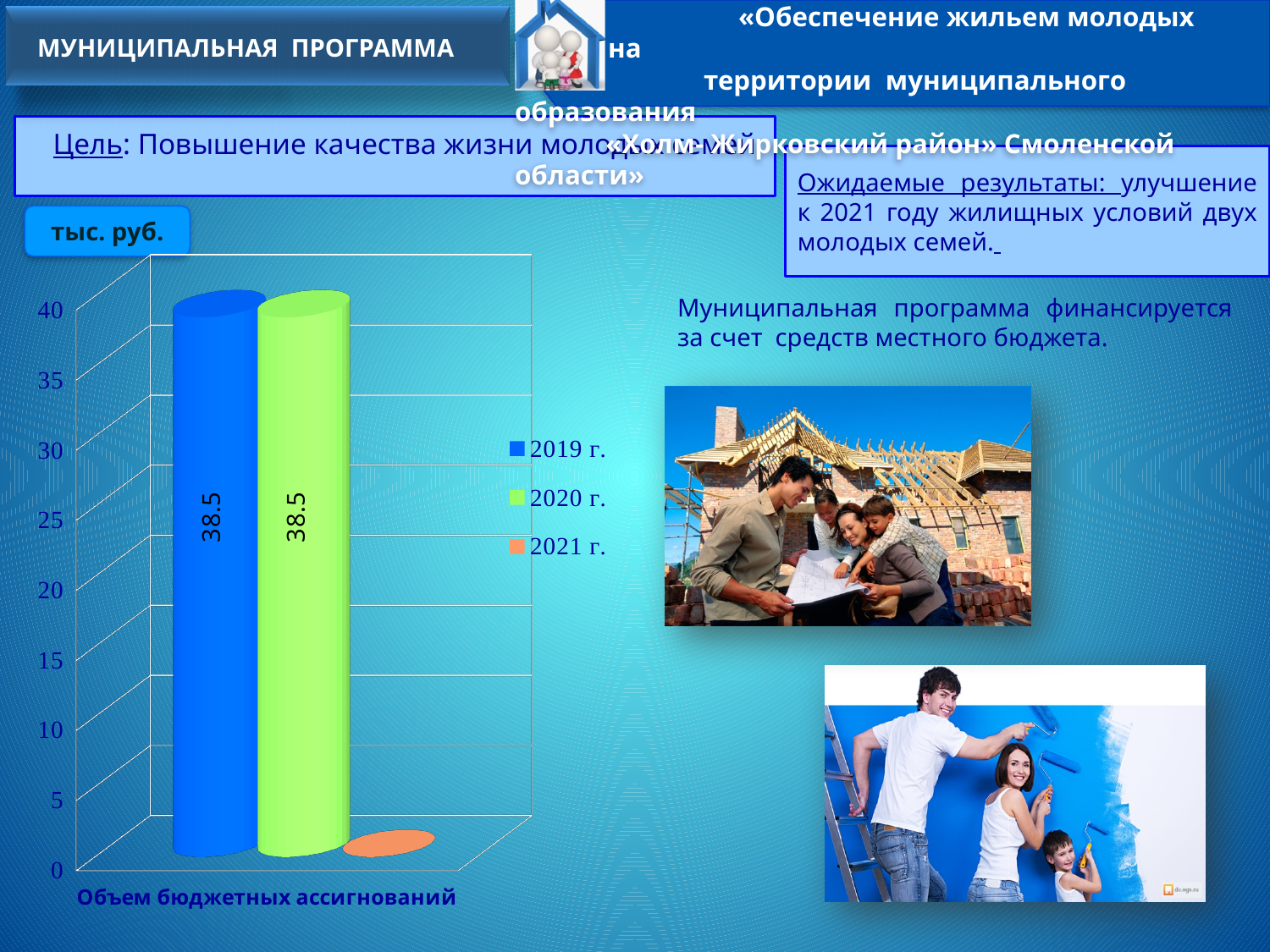
Which series has the lowest value in the chart? 2021 г. What is the category label shown under the bars? Объем бюджетных ассигнований What kind of chart is shown on the slide? bar chart How many categories are shown on the x axis of the chart? 1 What is the difference between the values for 2019 г. and 2020 г.? 0 What is the value for the 2020 г. series in the chart? 38.5 How many series does the chart legend list? 3 What is the value for the 2019 г. series in the chart? 38.5 What unit is indicated for the chart values? тыс. руб. Is the value for 2019 г. greater or less than 35? greater Is the value for 2021 г. greater or less than 5? less